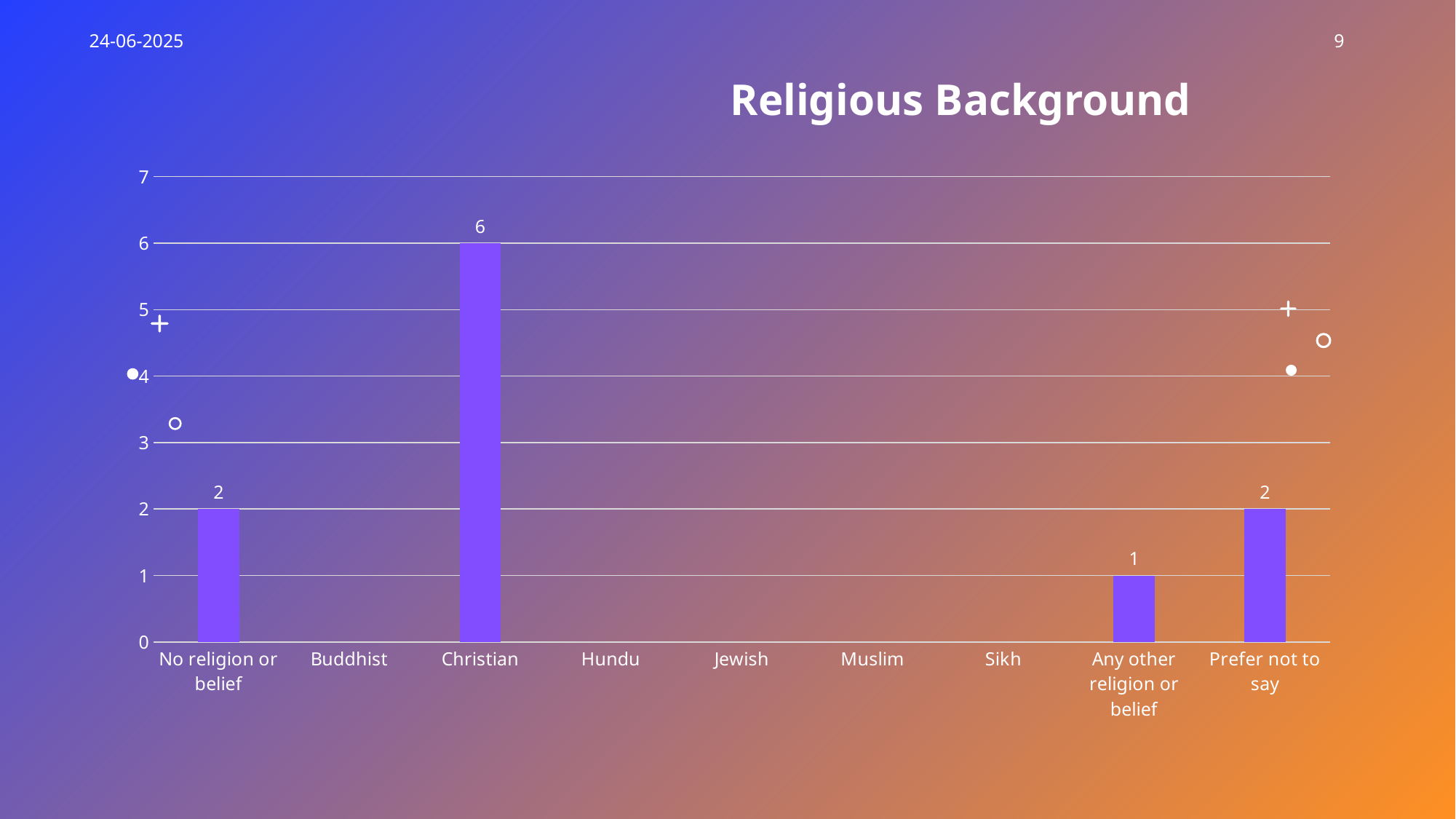
What is the value for No religion or belief? 2 What is the title of the chart? Religious Background What is the difference between the values for Prefer not to say and Any other religion or belief? 1 What is the value for Any other religion or belief? 1 Which category has the highest value in the chart? Christian How many categories are shown on the x axis of the chart? 9 What is the value for Prefer not to say? 2 What is the value for Christian in the Religious Background chart? 6 Which is larger, the value for Christian or the value for Prefer not to say? Christian Is the value for Christian greater or less than 5? greater What kind of chart is shown on the slide? bar chart What is the difference between the values for Christian and No religion or belief? 4